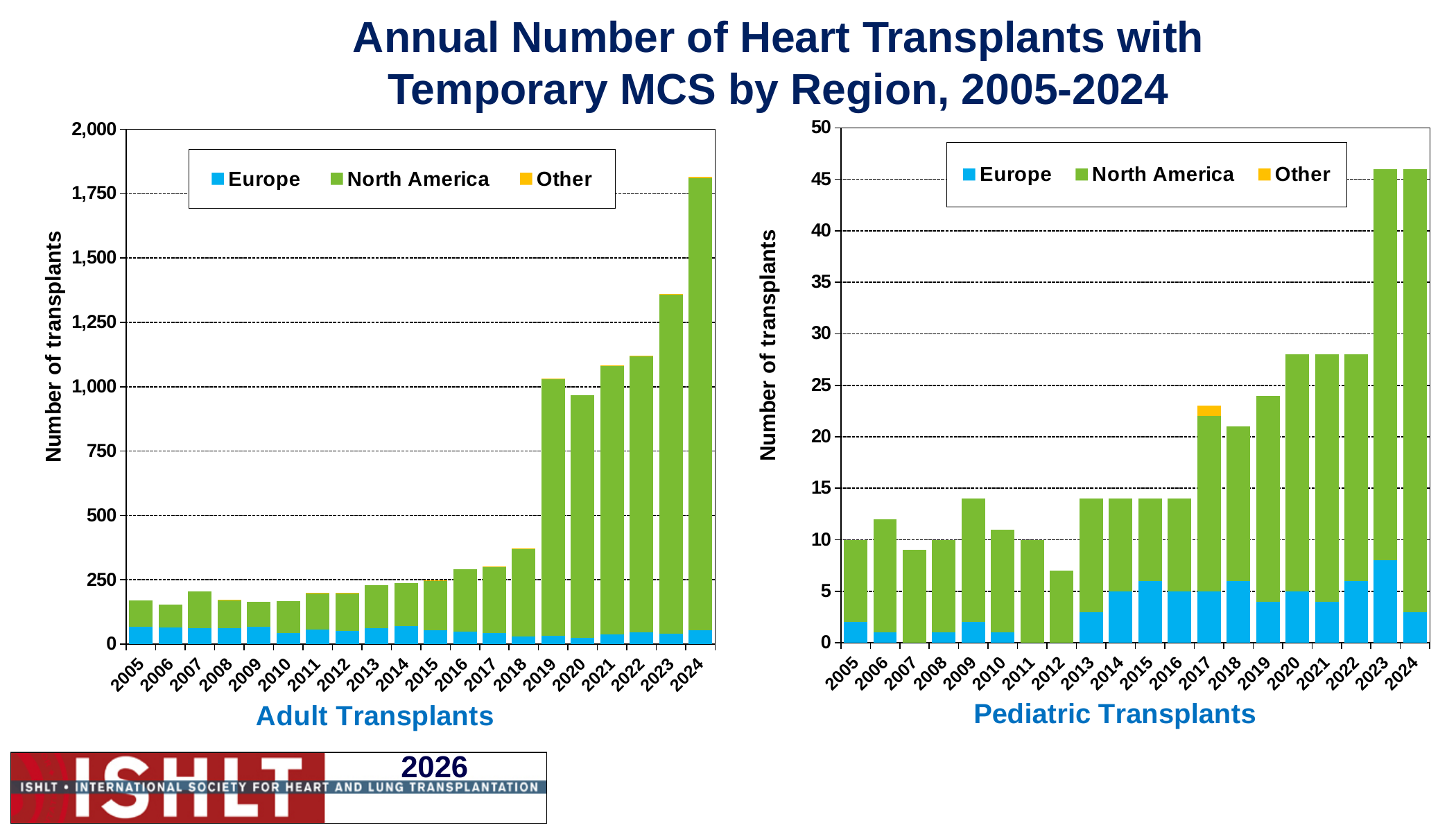
In the Adult Transplants chart, is the total for 2018 greater or less than 500? less In the Pediatric Transplants chart, is the total for 2020 greater or less than 25? greater In the Pediatric Transplants chart, which year has the lowest total number of transplants? 2012 In the Adult Transplants chart, which colour represents Europe? blue In the Adult Transplants chart, which year has the highest total number of transplants? 2024 What kind of chart is the Adult Transplants chart? bar chart In the Adult Transplants chart, do the totals generally rise or fall from 2005 to 2024? rise In the Adult Transplants chart, is the total for 2024 greater or less than 1,750? greater How many years are shown on the x axis of the Adult Transplants chart? 20 In the Pediatric Transplants chart, which year has the larger total, 2009 or 2010? 2009 In the Pediatric Transplants chart, what is the total number of transplants in 2005? 10 How many series does the legend of the Pediatric Transplants chart list? 3